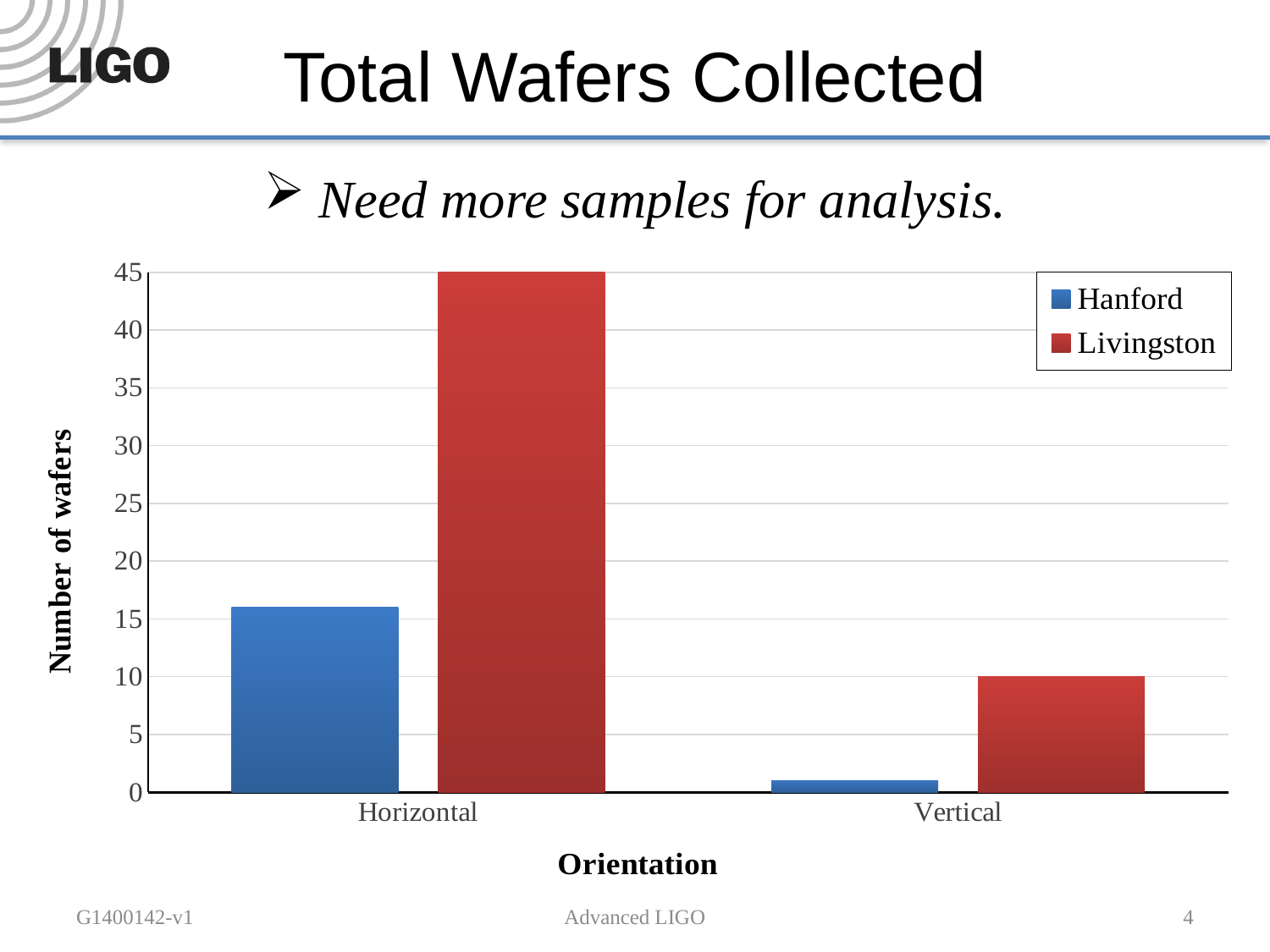
Is the value for Hanford in the Horizontal orientation greater or less than 20? less Which bar is the highest in the chart? Livingston, Horizontal Which is larger for the Vertical orientation, Hanford or Livingston? Livingston What is the number of wafers for Livingston in the Horizontal orientation? 45 What is the difference between Livingston's Horizontal and Vertical values? 35 What is the label of the y axis? Number of wafers Is the value for Hanford in the Vertical orientation greater or less than 5? less How many series does the legend list? 2 What is the number of wafers for Livingston in the Vertical orientation? 10 How many orientation categories are shown on the x axis? 2 What kind of chart is shown on the slide? bar chart Which bar is the lowest in the chart? Hanford, Vertical